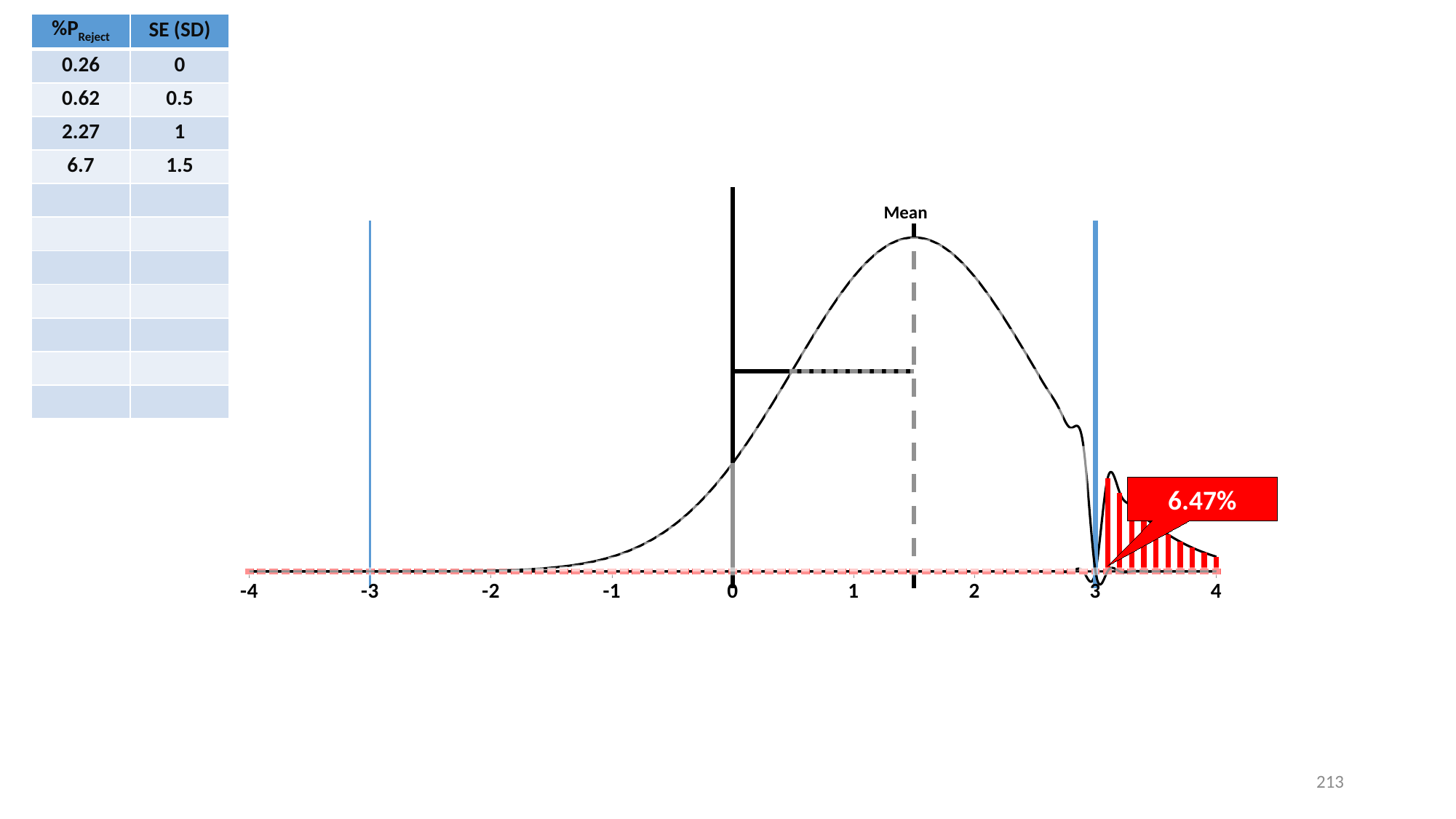
Is the Mean line positioned at an x value greater or less than 1? greater Does the curve rise or fall as x increases from -4 to the Mean line? rise What percentage is shown in the red callout on the chart? 6.47% At which x-axis value is the thin blue vertical line on the left side of the chart? -3 What label is attached to the dashed vertical line at the peak of the curve? Mean Is the Mean line positioned at an x value greater or less than 2? less How many tick labels are shown on the x axis? 9 At which x-axis value does the red shaded tail region begin? 3 What is the highest value labelled on the x axis? 4 What is the lowest value labelled on the x axis? -4 At which x-axis value is the thick black vertical line drawn? 0 What kind of chart is shown on the slide? line chart